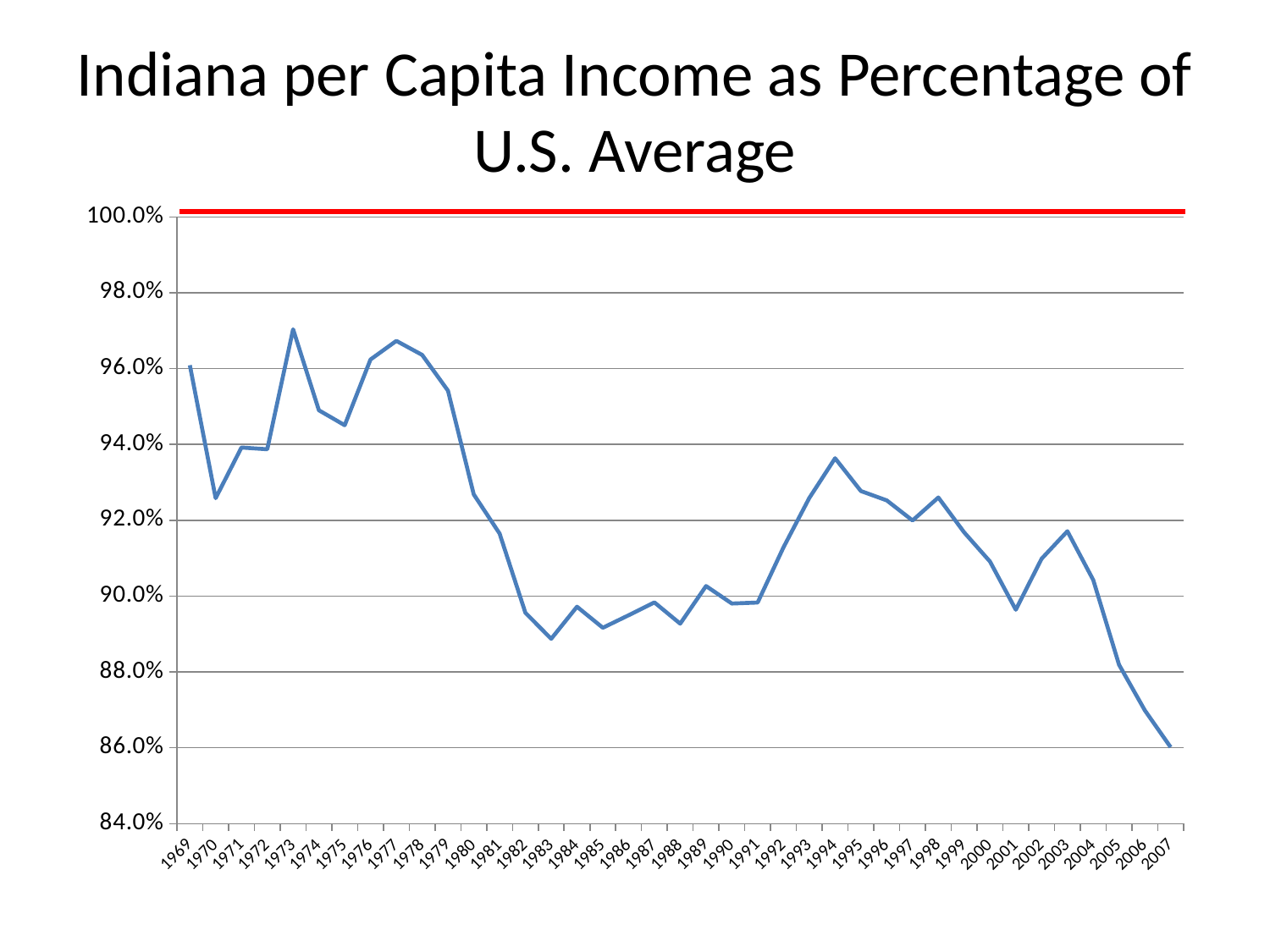
At what level is the horizontal red line drawn? 100.0% Is the value for 1983 greater or less than 90.0%? less Is the value for 1994 greater or less than 92.0%? greater How many years are plotted along the x axis? 39 Which is larger, the value for 1994 or the value for 2003? 1994 What kind of chart is shown on the slide? line chart Which is larger, the value for 1973 or the value for 1983? 1973 Is the value for 1973 greater or less than 96.0%? greater Which year has the lowest value for Indiana per capita income as a percentage of the U.S. average? 2007 Overall, does the blue line rise or fall from 1969 to 2007? fall